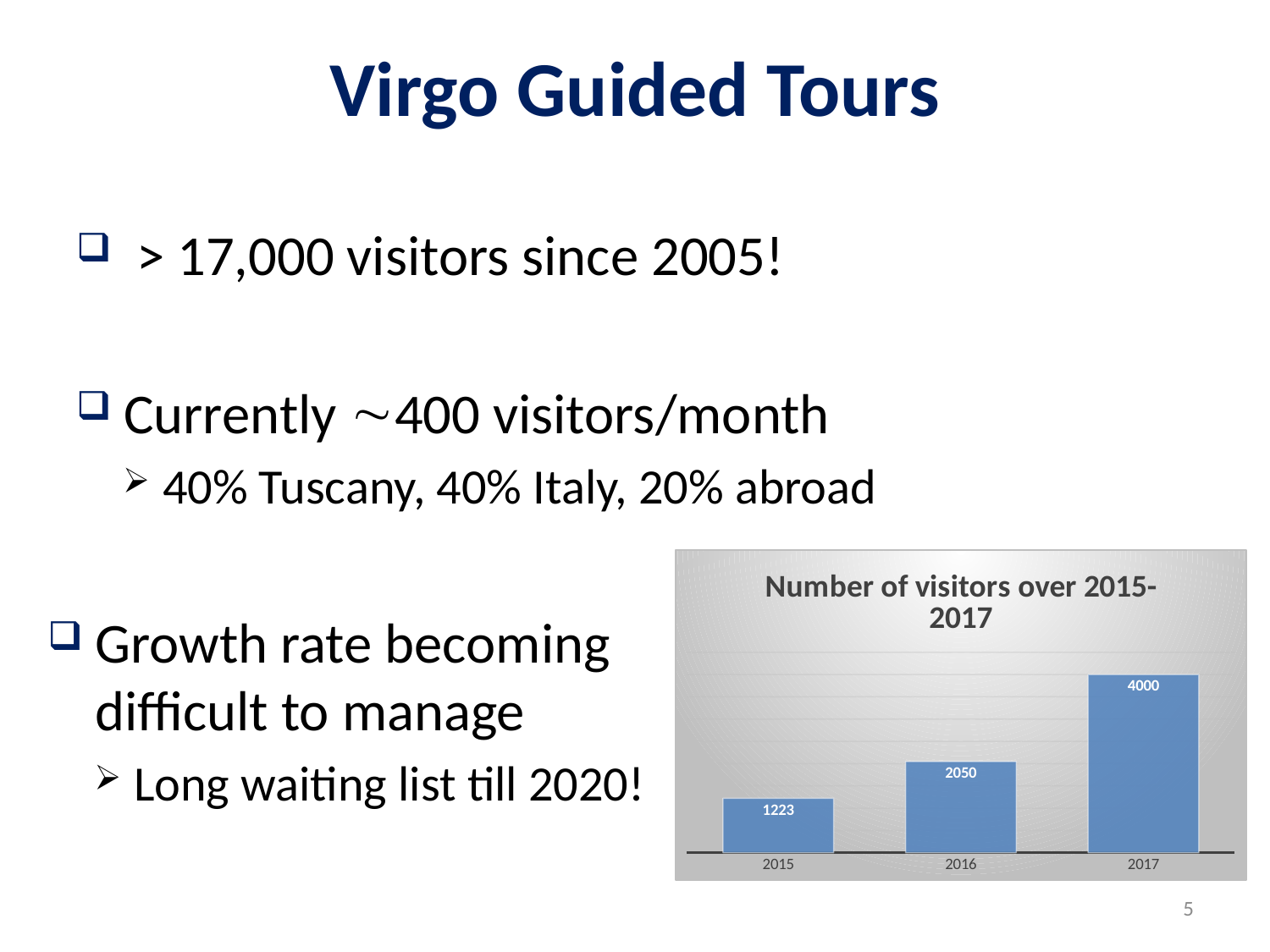
What is the difference in visitors between 2017 and 2016? 1950 Which year has the highest number of visitors? 2017 How many years are shown on the chart? 3 What is the difference in visitors between 2016 and 2015? 827 What is the number of visitors shown for 2016? 2050 What kind of chart is shown on the slide? Bar chart Which year has the lowest number of visitors? 2015 What is the number of visitors shown for 2017? 4000 What is the number of visitors shown for 2015? 1223 What is the title of the chart? Number of visitors over 2015-2017 Which year had more visitors, 2015 or 2016? 2016 Do the visitor numbers rise or fall from 2015 to 2017? Rise